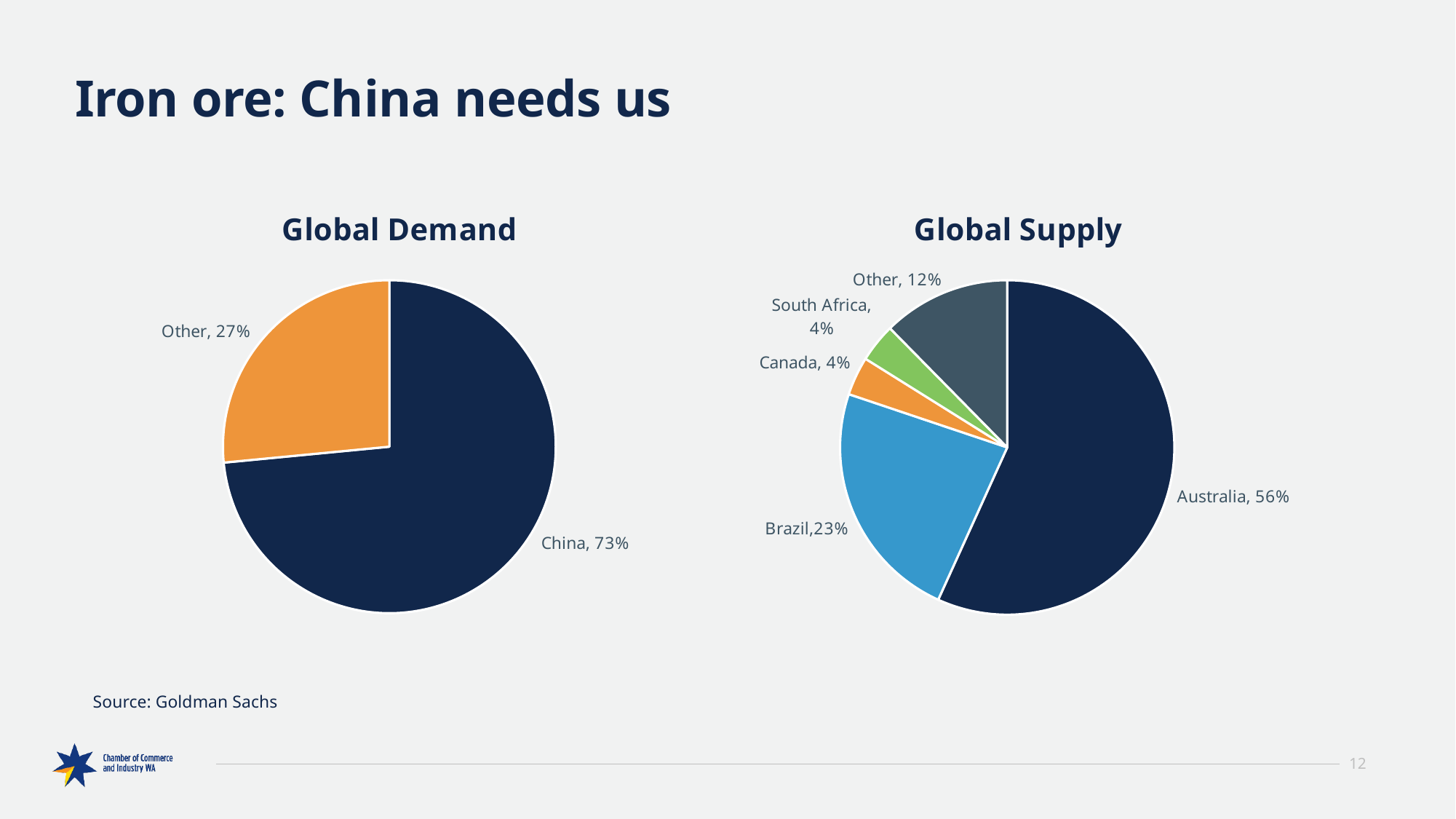
What kind of chart is the Global Demand chart? Pie chart In the Global Demand chart, what share of global demand does China account for? 73% In the Global Supply chart, what is the difference between Australia's share and Brazil's share? 33 percentage points In the Global Demand chart, what is the difference between China's share and Other's share? 46 percentage points In the Global Demand chart, what is the value for Other? 27% In the Global Supply chart, which is larger, Brazil or Other? Brazil In the Global Supply chart, how many slices are there? 5 In the Global Supply chart, what is the value for Canada? 4% In the Global Supply chart, what share does Australia hold? 56% In the Global Supply chart, what is the value for Brazil? 23% What is the title of the chart on the right side of the slide? Global Supply In the Global Supply chart, which country has the largest share? Australia